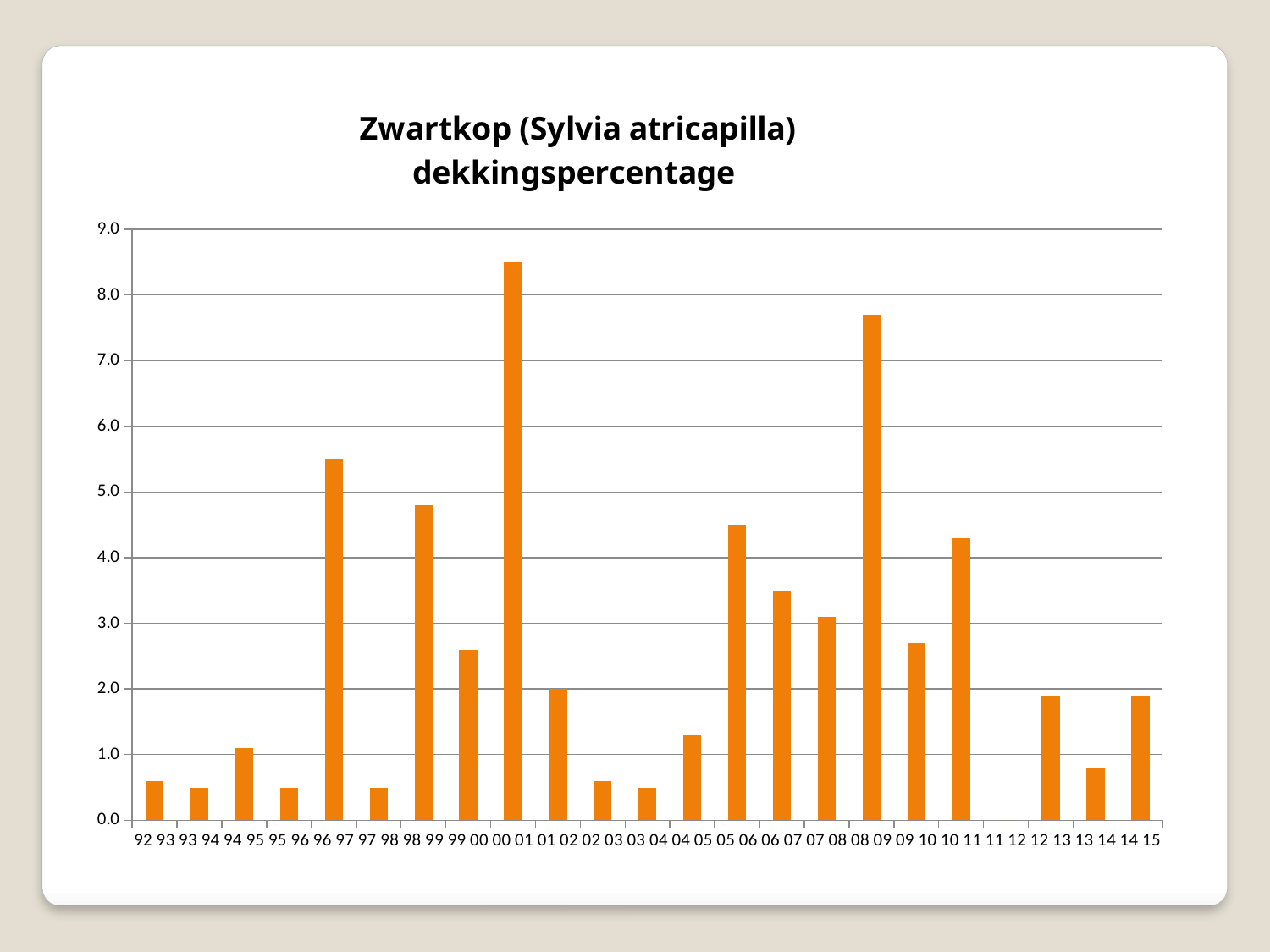
How many year categories are shown on the x axis? 23 Which is larger, the value for 00 01 or the value for 08 09? 00 01 Is the value for 99 00 greater or less than 3.0? less What is the title of the chart? Zwartkop (Sylvia atricapilla) dekkingspercentage Which year category has the highest value? 00 01 Is the value for 08 09 greater or less than 8.0? less What kind of chart is shown on the slide? bar chart Is the value for 96 97 greater or less than 5.0? greater Which is larger, the value for 96 97 or the value for 98 99? 96 97